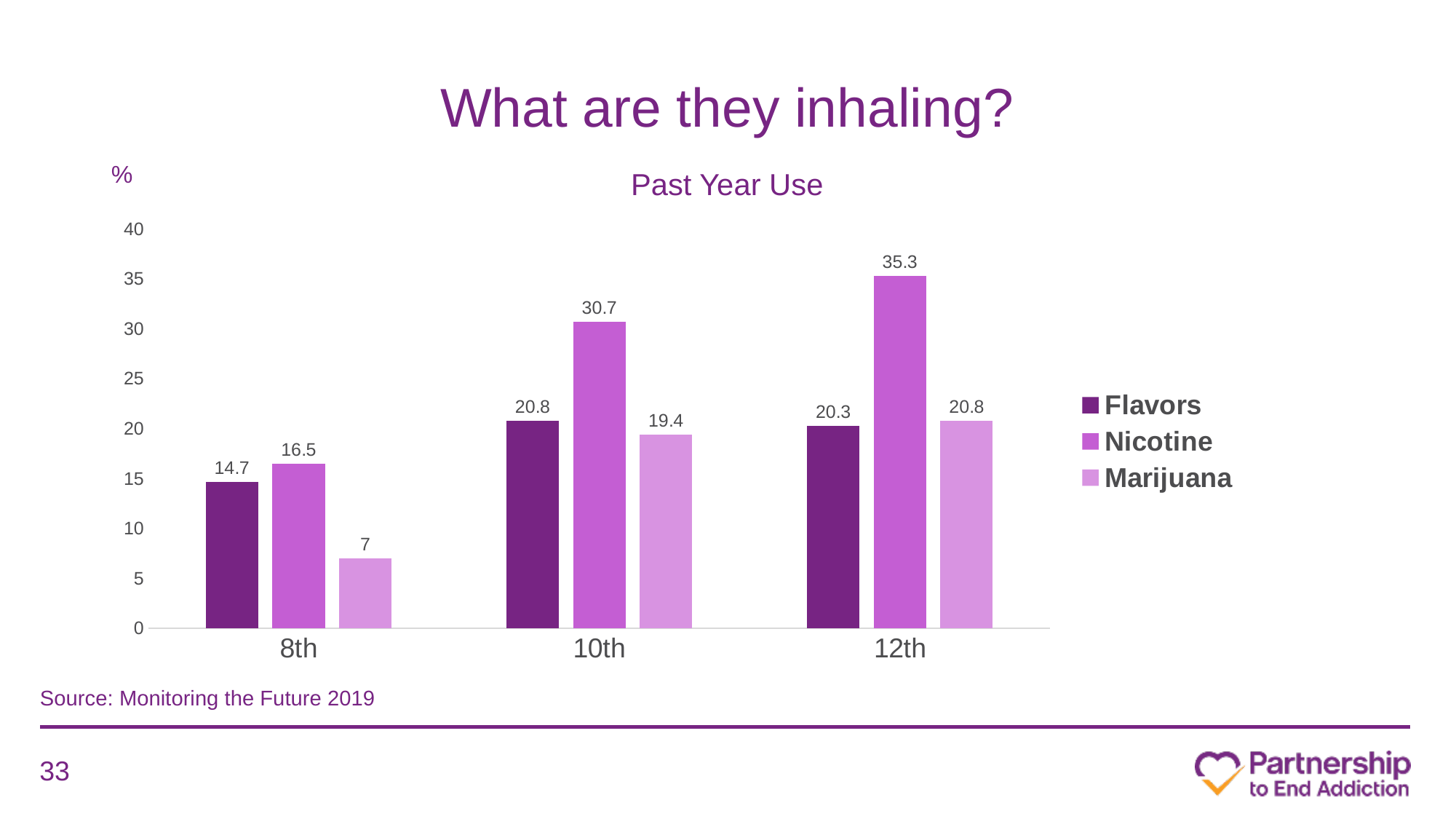
Which grade has the lowest Marijuana value? 8th What is the Flavors value for 12th grade? 20.3 What kind of chart is shown? Bar chart Do the Nicotine values rise or fall from 8th to 12th grade? Rise What is the Marijuana value for 8th grade? 7 How many grade categories are shown on the x axis? 3 What is the difference between the Nicotine and Flavors values for 12th grade? 15 Which is larger for 10th grade, Flavors or Marijuana? Flavors What is the title of the chart? Past Year Use Which grade has the highest Nicotine value? 12th What is the Nicotine value for 10th grade? 30.7 How many series does the legend list? 3